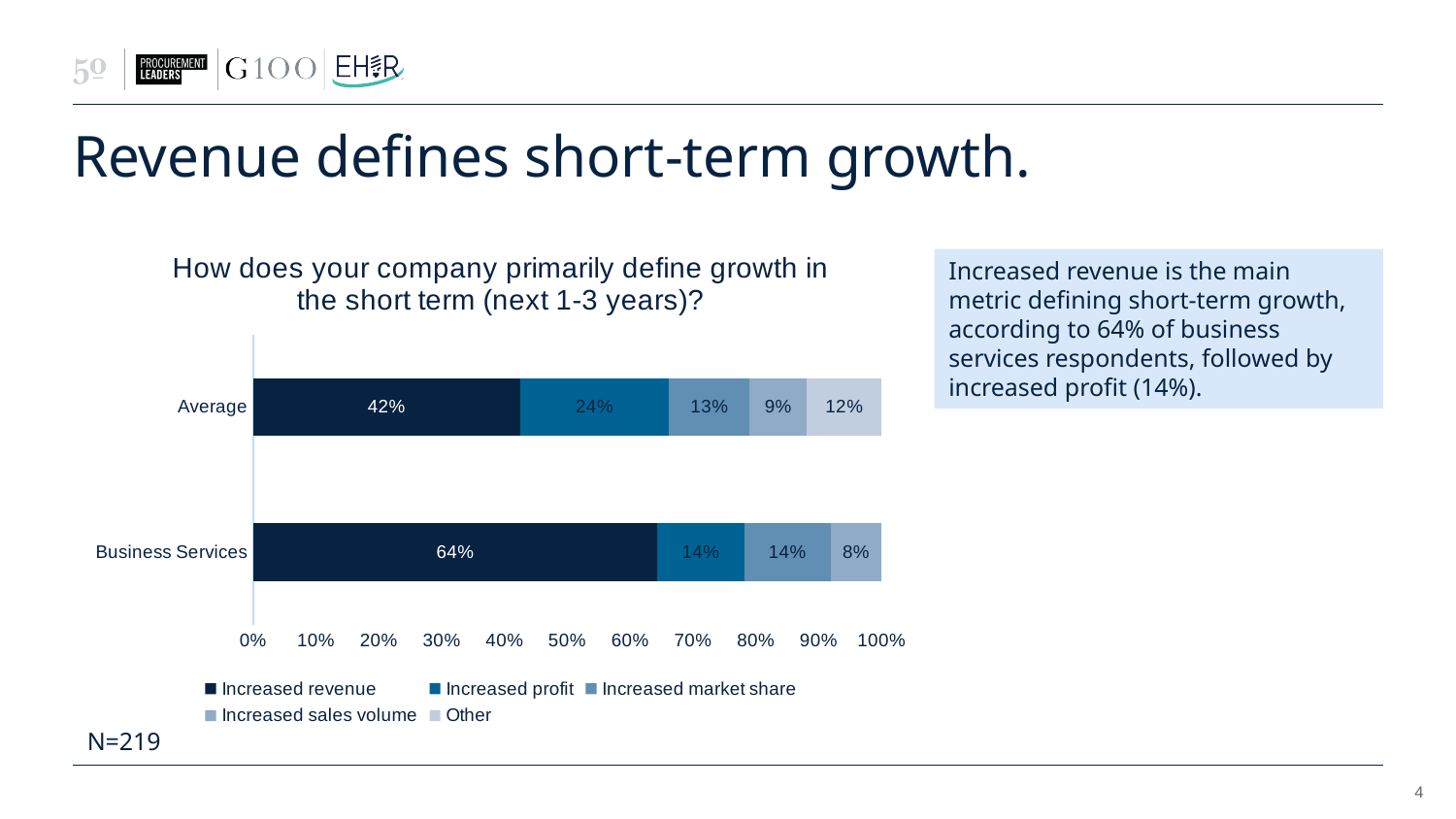
What is the difference between the Increased revenue values for Business Services and Average? 22% What is the value for Increased revenue in the Average bar? 42% Which series has the largest share in the Business Services bar? Increased revenue How many categories (bars) are shown on the chart? 2 Which is larger: Increased profit for Average or Increased profit for Business Services? Average What kind of chart is shown on the slide? Stacked bar chart What is the value for Increased profit in the Average bar? 24% How many series does the legend list? 5 What is the value for Increased sales volume in the Business Services bar? 8% What is the value for Increased revenue in the Business Services bar? 64% What is the value for Other in the Average bar? 12% Which series has the smallest share in the Average bar? Increased sales volume